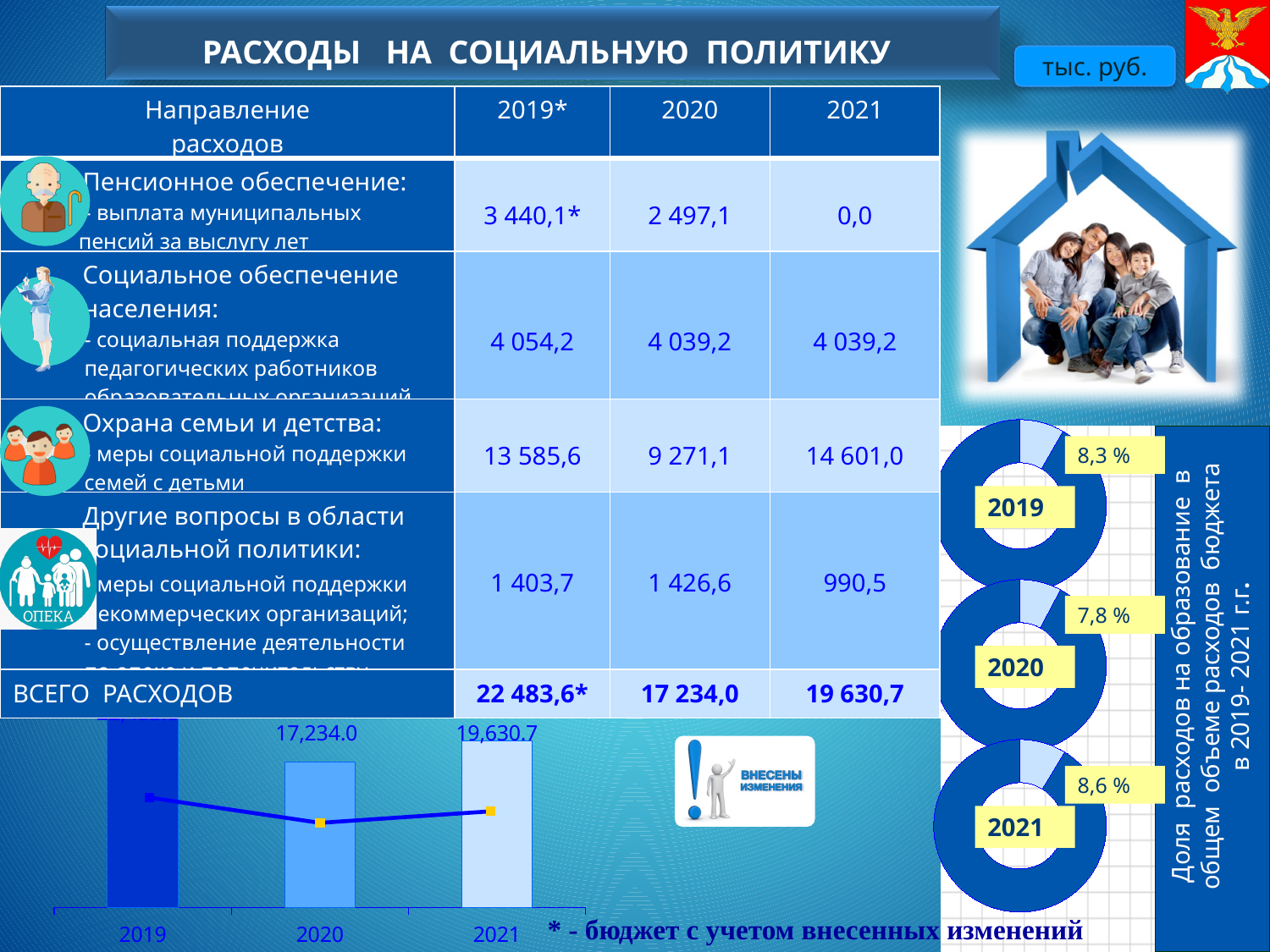
What kind of chart is shown at the bottom left of the slide? bar chart In the bar chart at the bottom left of the slide, which is larger: the value for 2020 or the value for 2021? 2021 In the donut charts on the right of the slide, what is the difference between the 2021 share and the 2020 share? 0,8 % In the bar chart at the bottom left of the slide, which year has the shortest bar? 2020 In the donut charts on the right of the slide, what share is shown for 2020? 7,8 % In the bar chart at the bottom left of the slide, what is the difference between the 2021 and 2020 values? 2,396.7 In the donut charts on the right of the slide, what share is shown for 2019? 8,3 % How many years are shown on the x axis of the bar chart at the bottom left of the slide? 3 In the bar chart at the bottom left of the slide, which year has the tallest bar? 2019 In the bar chart at the bottom left of the slide, what is the value shown for 2020? 17,234.0 In the donut charts on the right of the slide, which year has the highest share? 2021 In the bar chart at the bottom left of the slide, what is the value shown for 2021? 19,630.7